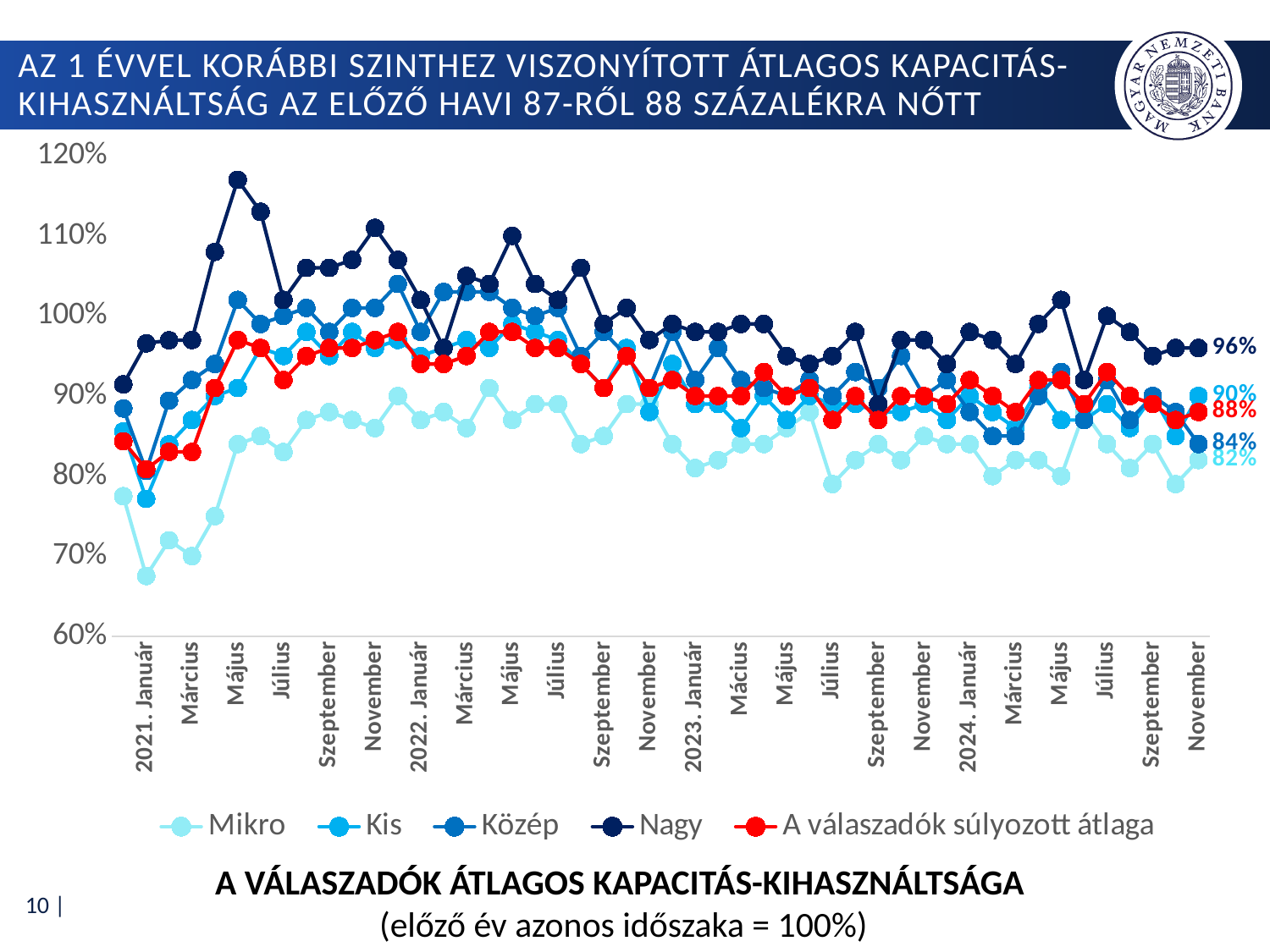
What is the value labelled for the Mikro series at the end of the chart (November 2024)? 82% Which series is drawn in red? A válaszadók súlyozott átlaga What is the value labelled for A válaszadók súlyozott átlaga at the end of the chart (November 2024)? 88% How many series does the legend list? 5 What is the value labelled for the Kis series at the end of the chart (November 2024)? 90% Which series has the lowest value at the end of the chart (November 2024)? Mikro What is the difference between the Nagy and Mikro values labelled at the end of the chart (November 2024)? 14 percentage points Which series has the highest value at the end of the chart (November 2024)? Nagy What is the value labelled for the Közép series at the end of the chart (November 2024)? 84% What is the value labelled for the Nagy series at the end of the chart (November 2024)? 96% Is the peak value of the Nagy series in May 2021 greater or less than 110%? greater What type of chart is shown on the slide? line chart